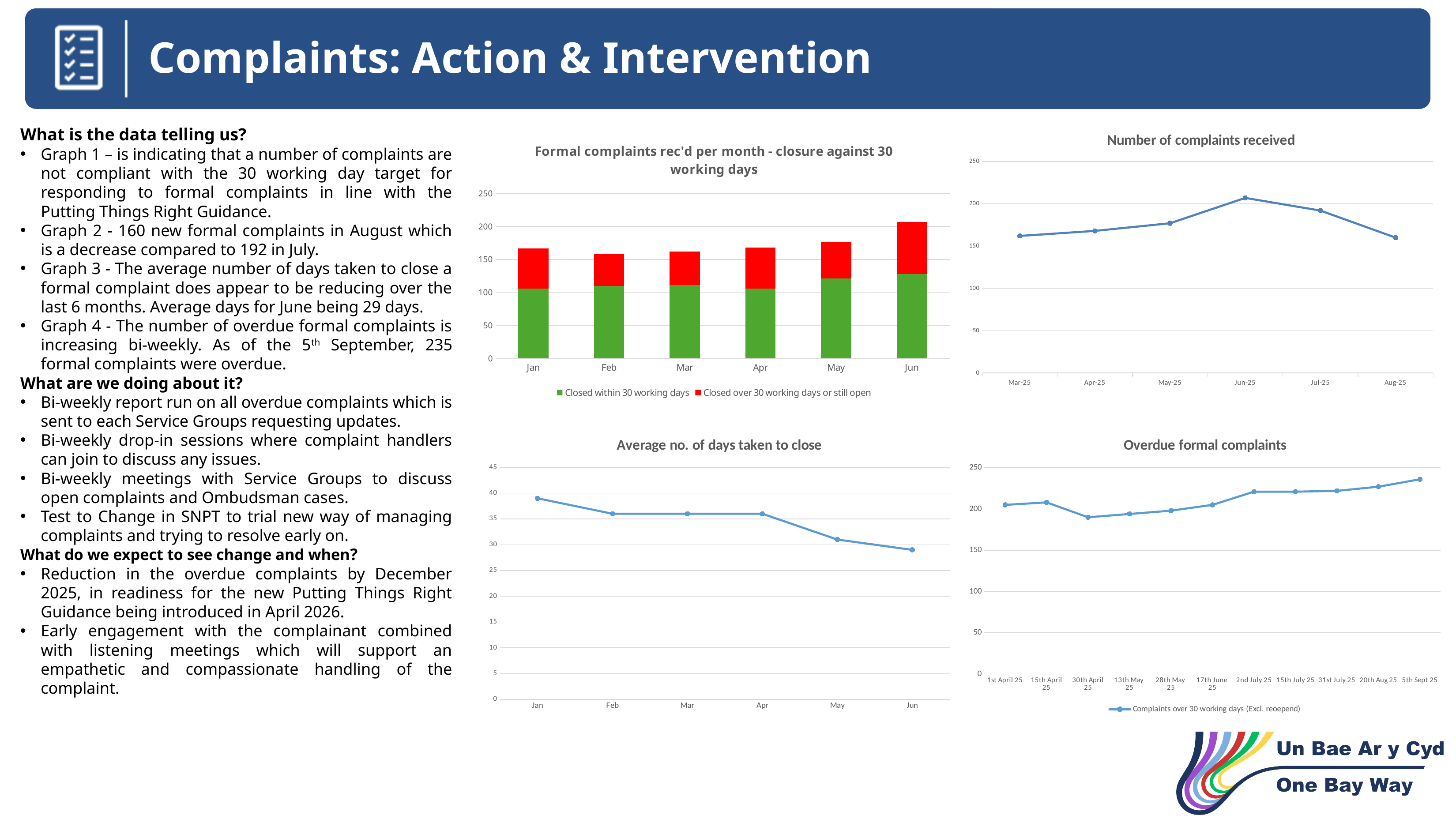
In the chart titled 'Average no. of days taken to close', which month has the lowest value? Jun In the chart titled 'Number of complaints received', which month has the highest value? Jun-25 In the chart titled 'Formal complaints rec'd per month - closure against 30 working days', how many series does the legend list? 2 In the chart titled 'Overdue formal complaints', which date has the highest value? 5th Sept 25 In the chart titled 'Number of complaints received', is the value for Jun-25 greater or less than 200? greater In the chart titled 'Number of complaints received', how many months are plotted? 6 In the chart titled 'Overdue formal complaints', how many data points are plotted? 11 In the chart titled 'Formal complaints rec'd per month - closure against 30 working days', is the total for Jun greater or less than 200? greater In the chart titled 'Formal complaints rec'd per month - closure against 30 working days', what kind of chart is used? Stacked bar chart In the chart titled 'Average no. of days taken to close', do the values generally rise or fall from Jan to Jun? fall In the chart titled 'Formal complaints rec'd per month - closure against 30 working days', which month has the tallest bar? Jun In the chart titled 'Average no. of days taken to close', is the value for Jan greater or less than 35? greater